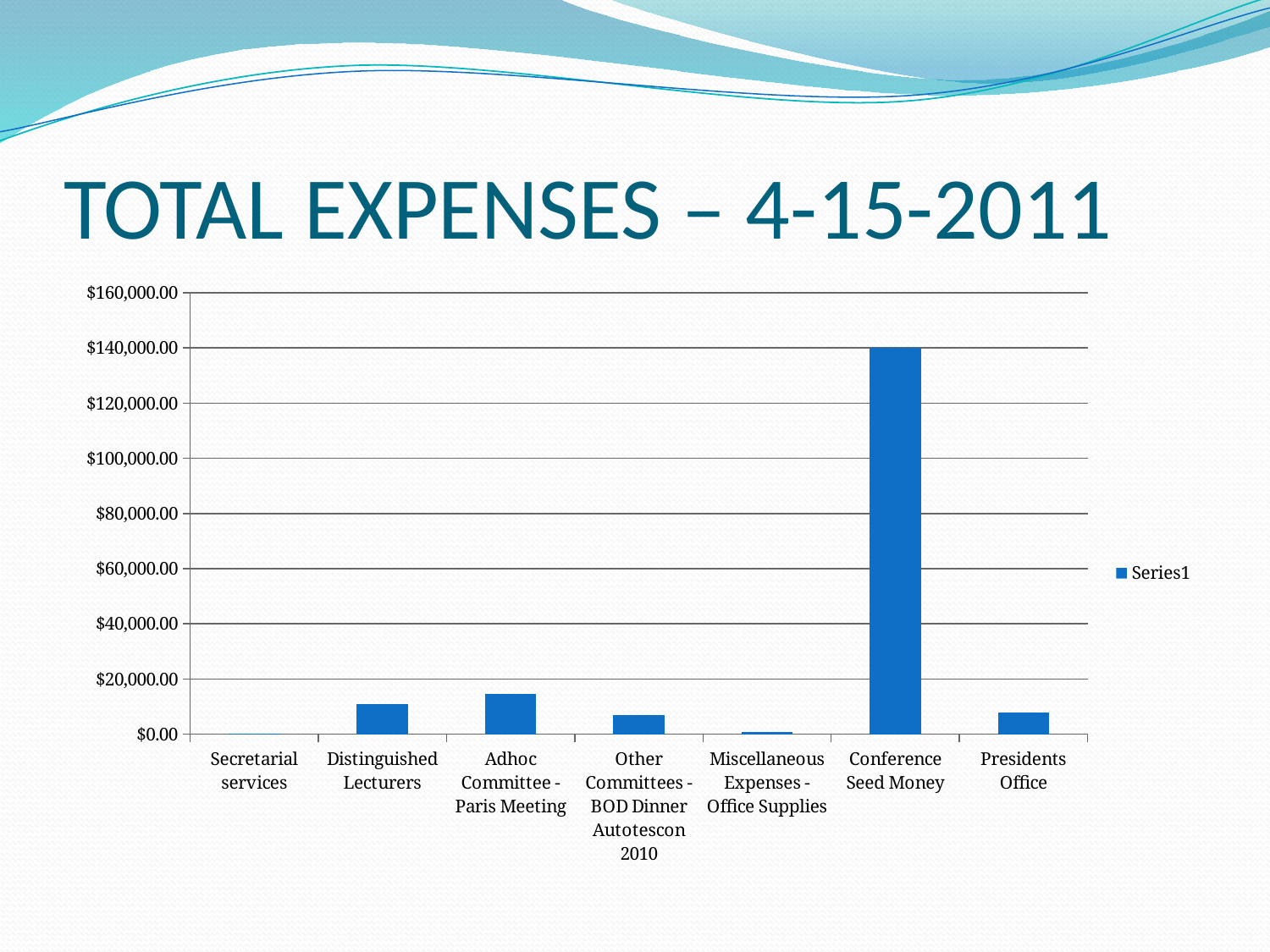
How many series does the legend list? 1 What type of chart is shown on the slide? Bar chart Is the value for Distinguished Lecturers greater or less than $20,000.00? less How many expense categories are shown on the x axis? 7 Which category has the highest expense? Conference Seed Money Which is larger, the expense for Adhoc Committee - Paris Meeting or for Distinguished Lecturers? Adhoc Committee - Paris Meeting What is the name of the series shown in the legend? Series1 Which is larger, the expense for Conference Seed Money or for Presidents Office? Conference Seed Money Is the value for Conference Seed Money greater or less than $100,000.00? greater Is the value for Presidents Office greater or less than $20,000.00? less What is the title of the chart on the slide? TOTAL EXPENSES – 4-15-2011